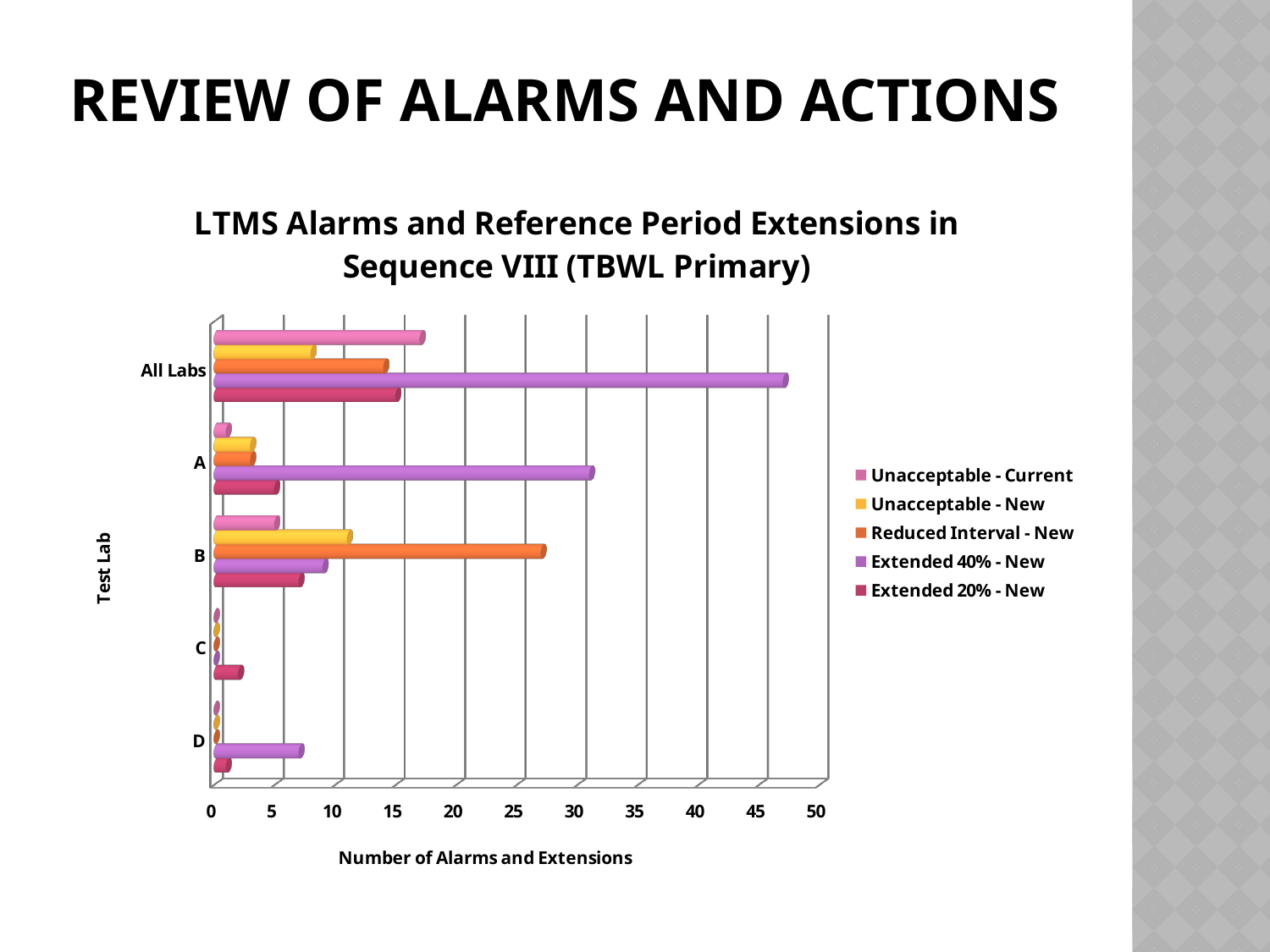
What is the title of the chart? LTMS Alarms and Reference Period Extensions in Sequence VIII (TBWL Primary) Which is larger for lab B: Reduced Interval - New or Unacceptable - New? Reduced Interval - New Which test lab has the highest value for Extended 40% - New? All Labs Is the value for Extended 40% - New for All Labs greater or less than 45? greater What kind of chart is shown on the slide? bar chart How many series does the legend list? 5 Which is larger for lab A: Extended 40% - New or Extended 20% - New? Extended 40% - New Is the value for Unacceptable - Current for All Labs greater or less than 20? less How many test lab categories are shown on the y axis? 5 What is the label of the x axis? Number of Alarms and Extensions Is the value for Reduced Interval - New for lab B greater or less than 25? greater